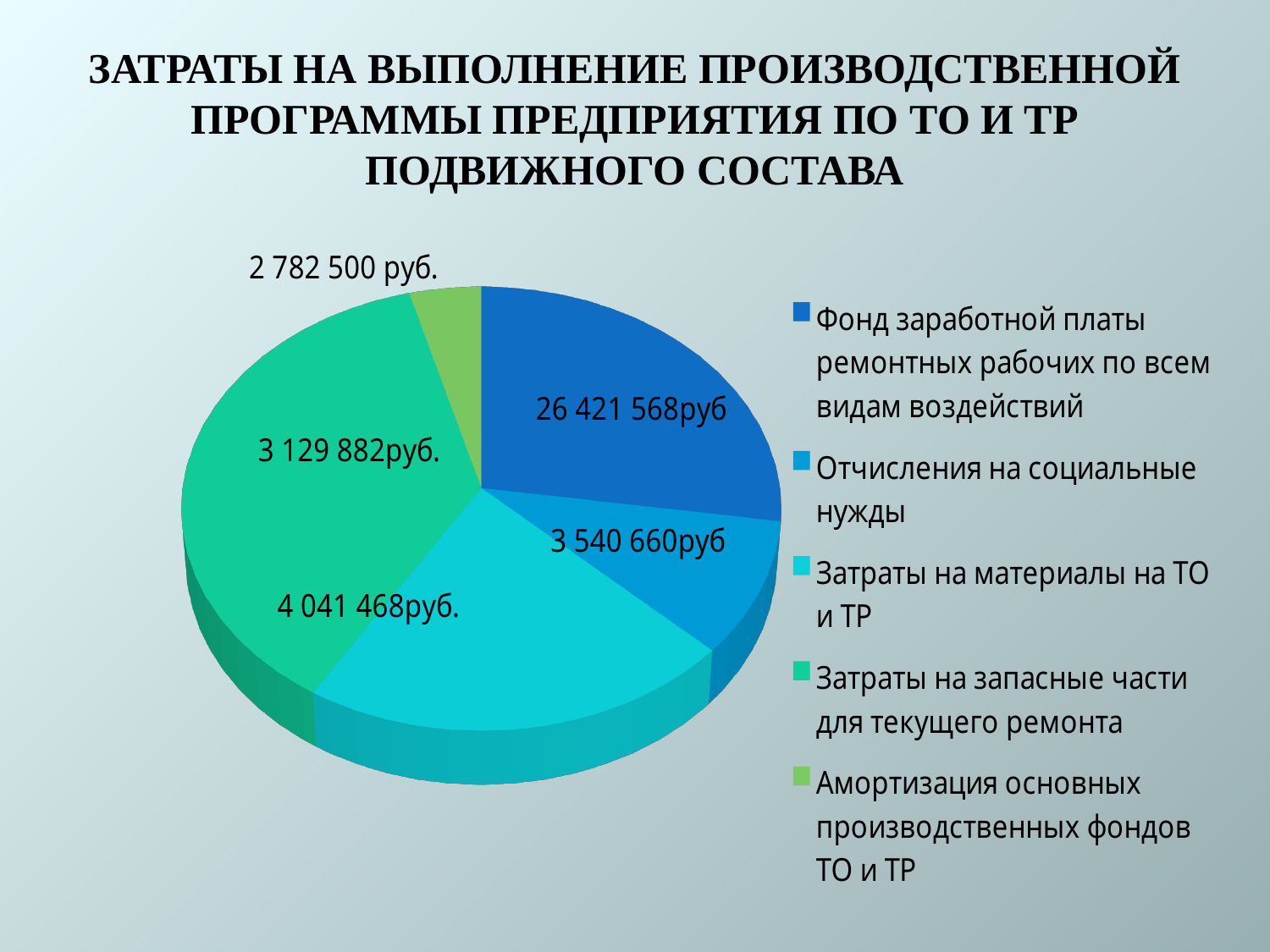
Which is larger: "Затраты на запасные части для текущего ремонта" or "Амортизация основных производственных фондов ТО и ТР"? Затраты на запасные части для текущего ремонта What is the value shown for "Отчисления на социальные нужды"? 3 540 660руб What is the value shown for "Амортизация основных производственных фондов ТО и ТР"? 2 782 500 руб. How many entries does the legend list? 5 What is the difference between the values for "Затраты на материалы на ТО и ТР" and "Отчисления на социальные нужды"? 500 808 руб. What is the difference between the values for "Затраты на запасные части для текущего ремонта" and "Амортизация основных производственных фондов ТО и ТР"? 347 382 руб. What is the value shown for "Затраты на материалы на ТО и ТР"? 4 041 468руб. What kind of chart is shown on the slide? pie chart How many slices does the pie chart have? 5 What is the value shown for "Затраты на запасные части для текущего ремонта"? 3 129 882руб. What is the value shown for "Фонд заработной платы ремонтных рабочих по всем видам воздействий"? 26 421 568руб Which is larger: "Затраты на материалы на ТО и ТР" or "Отчисления на социальные нужды"? Затраты на материалы на ТО и ТР